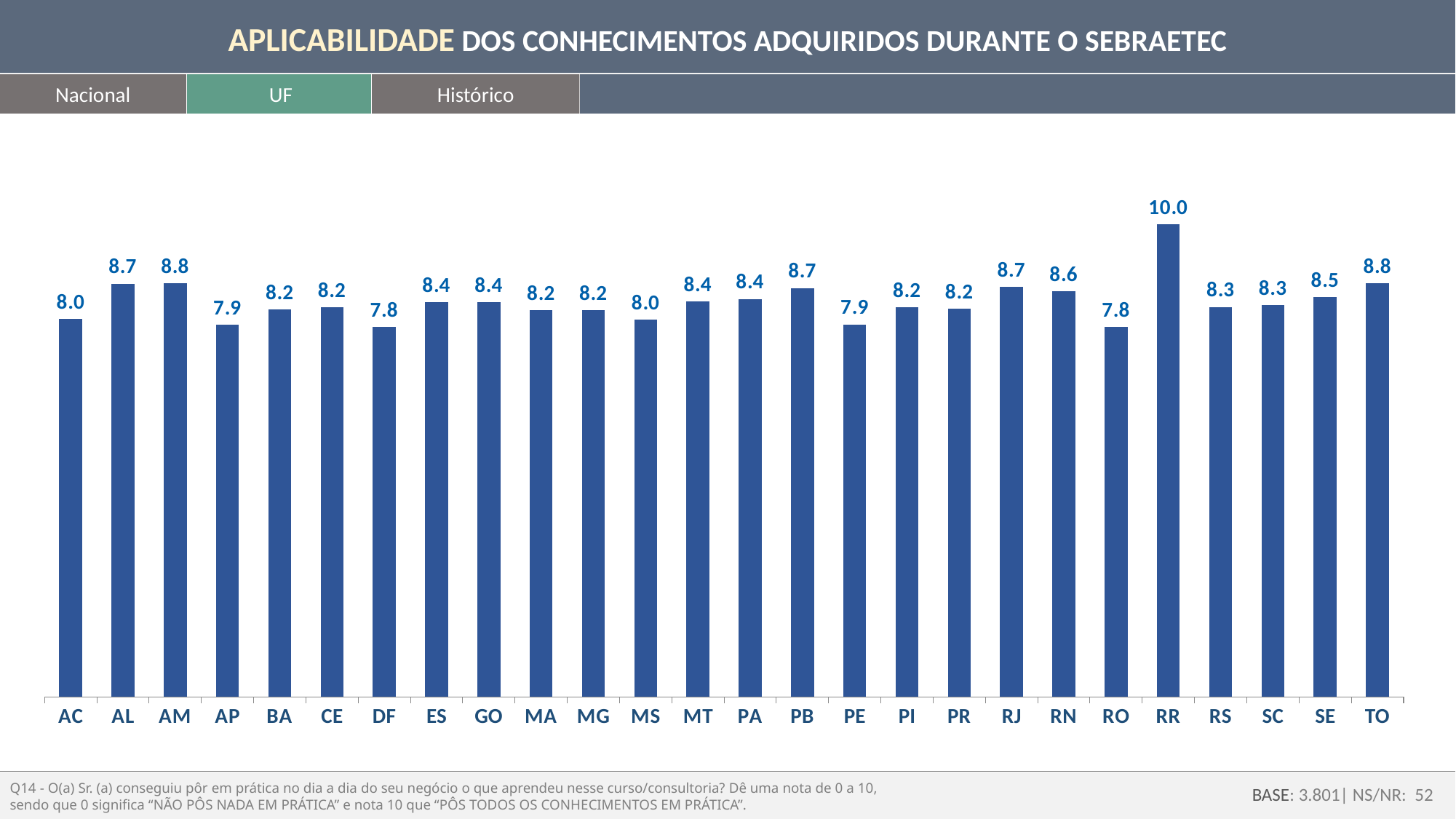
What is the difference between the values for AM and AP? 0.9 What is the title of the slide? APLICABILIDADE DOS CONHECIMENTOS ADQUIRIDOS DURANTE O SEBRAETEC What is the value for PB? 8.7 What is the difference between the values for RR and AC? 2.0 What is the value for SE? 8.5 How many states (UF) are shown on the x axis? 26 Which two states share the lowest value? DF and RO What is the value for AC? 8.0 Which state has the highest value? RR What is the value for RR? 10.0 What kind of chart is shown on the slide? Bar chart Which is larger, the value for RN or the value for SE? RN